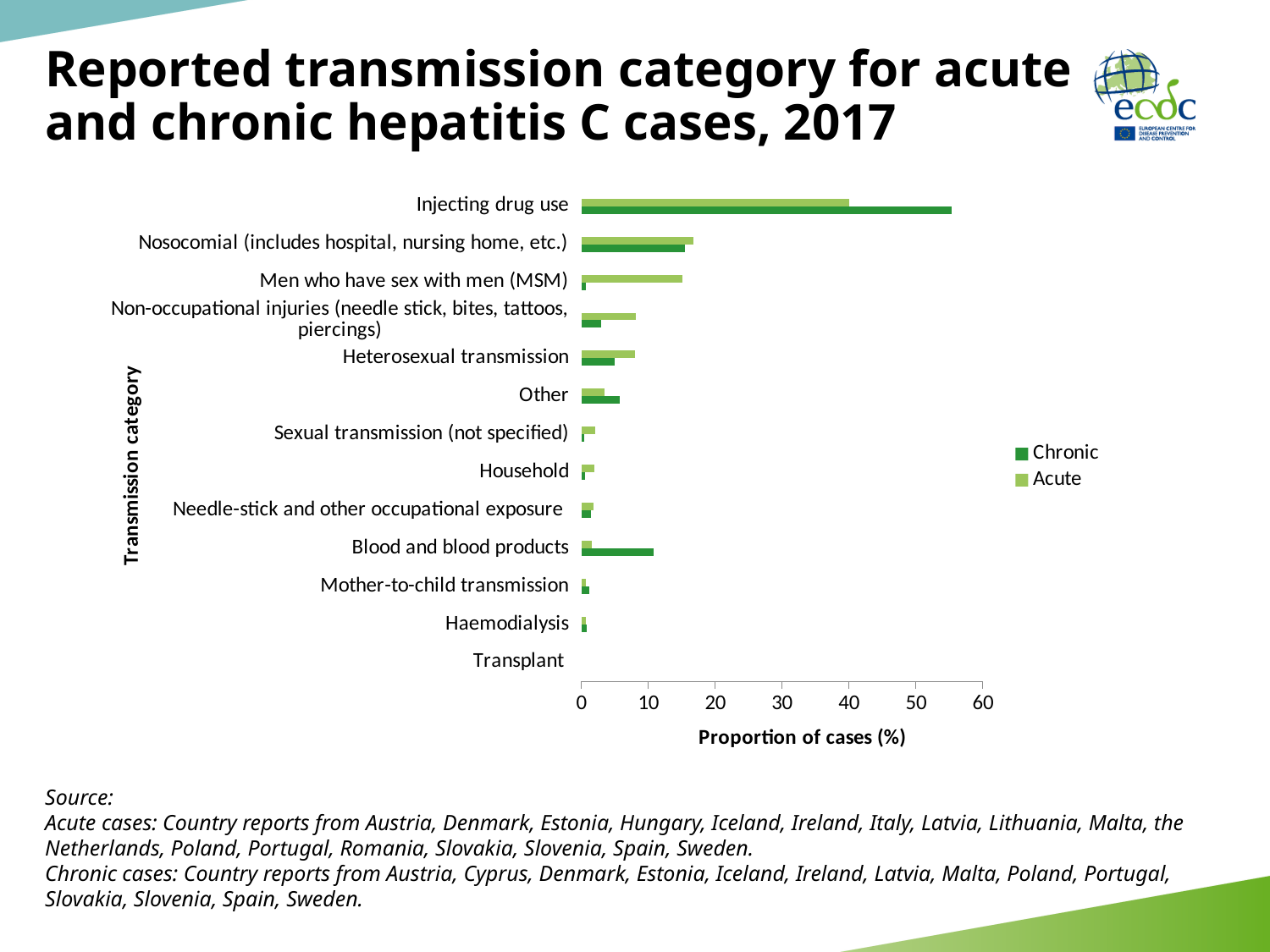
For Blood and blood products, which series has the larger value, Chronic or Acute? Chronic Which transmission category has the highest proportion of chronic cases? Injecting drug use Is the Acute value for Injecting drug use greater or less than 50? less Is the Chronic value for Injecting drug use greater or less than 50? greater How many series does the legend list? 2 What is the title of the x axis? Proportion of cases (%) What kind of chart is shown on the slide? Bar chart Which transmission category has the highest proportion of acute cases? Injecting drug use Which series is shown in the darker green colour? Chronic How many transmission categories are listed on the y axis? 13 For Men who have sex with men (MSM), which series has the larger value, Chronic or Acute? Acute